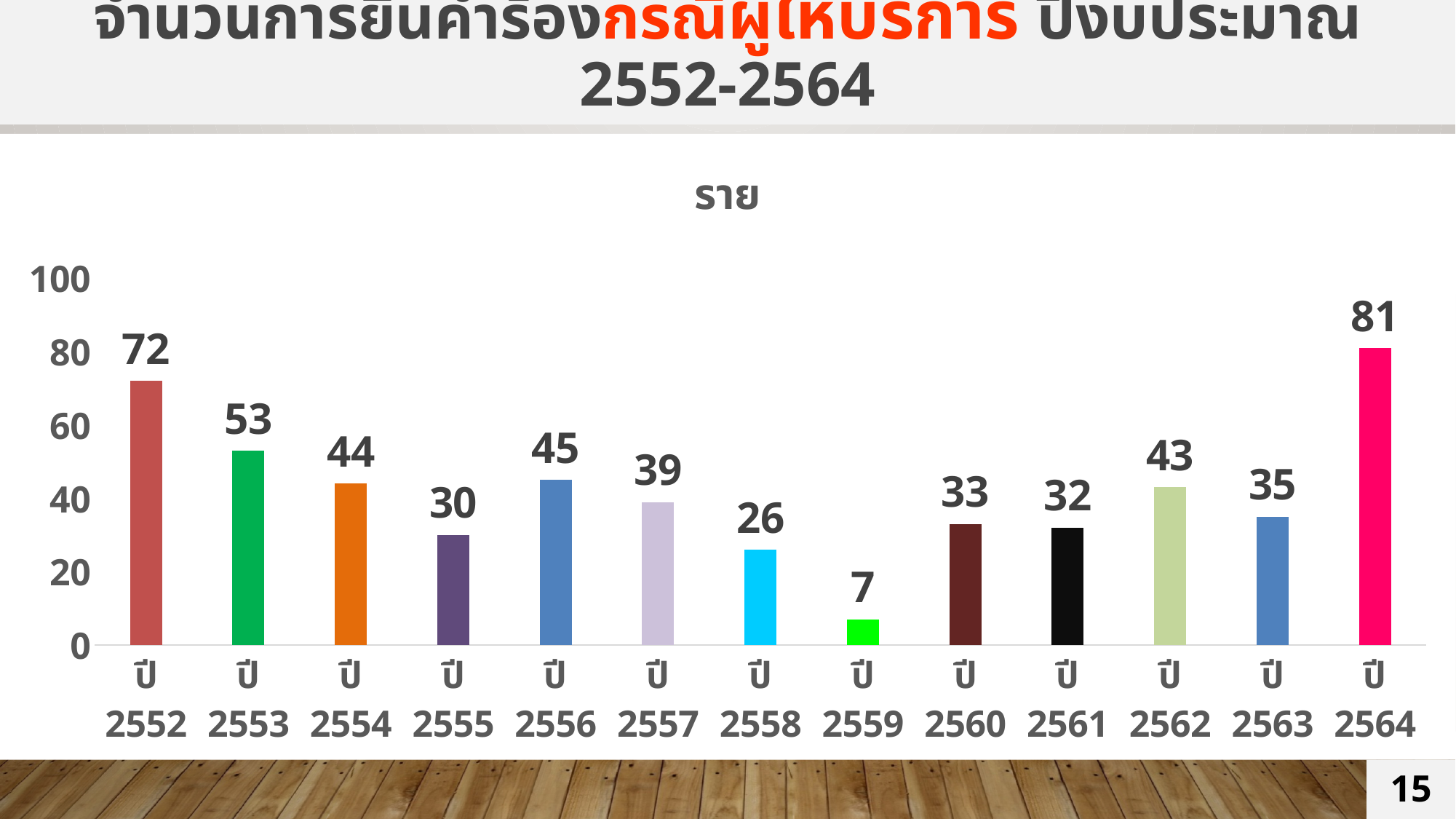
How many years are shown on the x axis? 13 What is the value for ปี 2552? 72 What kind of chart is shown on the slide? bar chart Which year has the lowest value? ปี 2559 Which year has the highest value? ปี 2564 What is the value for ปี 2559? 7 Which is larger, the value for ปี 2556 or the value for ปี 2557? ปี 2556 What is the title shown above the chart? ราย Is the value for ปี 2555 greater or less than 40? less What is the difference between the values for ปี 2553 and ปี 2558? 27 What is the difference between the values for ปี 2564 and ปี 2552? 9 What is the value for ปี 2562? 43